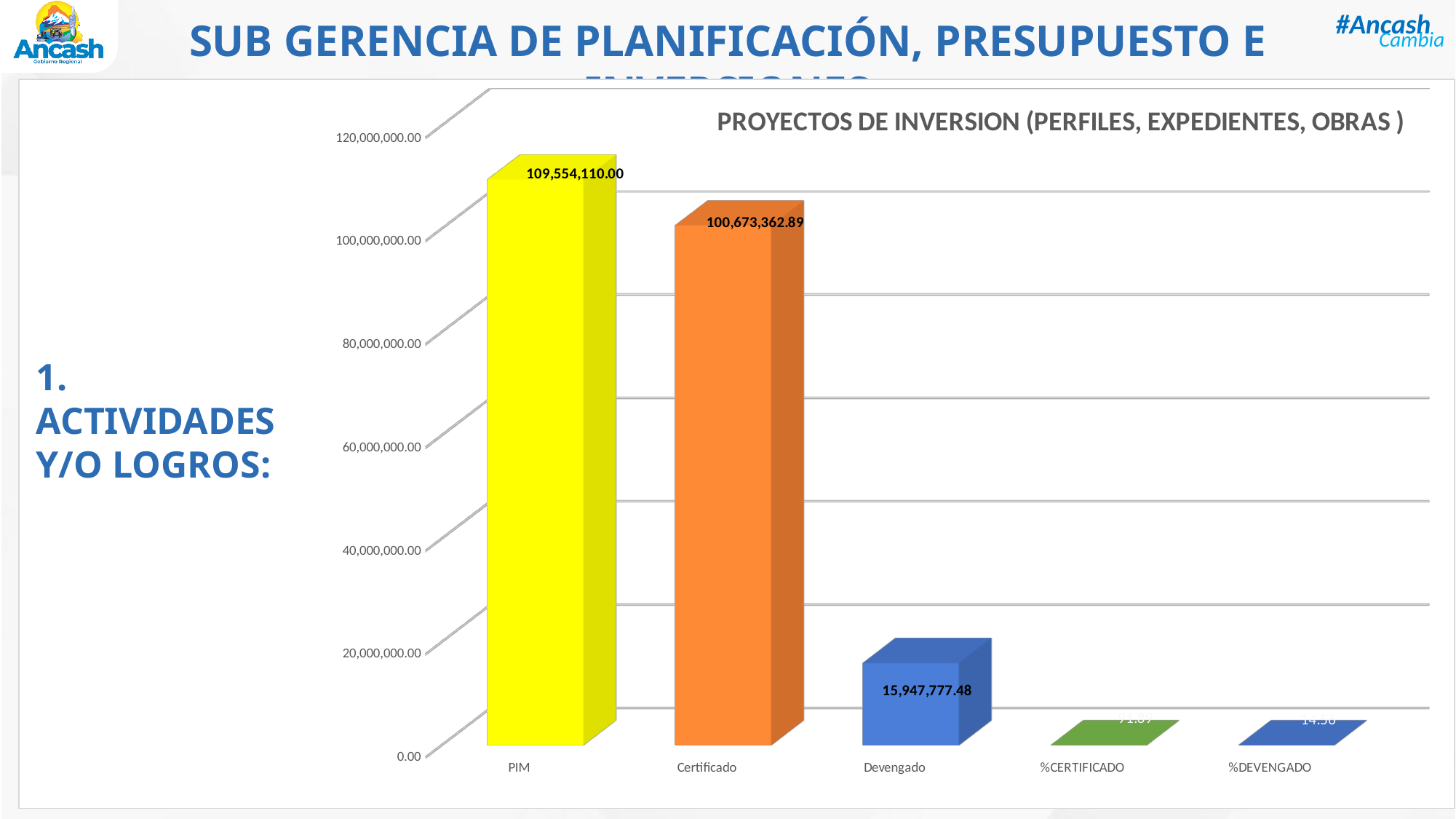
What is the value for Devengado? 15,947,777.48 What is the difference between the Certificado value and the Devengado value? 84,725,585.41 Which category has the highest value? PIM What kind of chart is shown on the slide? Bar chart Is the value for Devengado greater or less than 20,000,000.00? less What is the title of the chart? PROYECTOS DE INVERSION (PERFILES, EXPEDIENTES, OBRAS ) What is the value for PIM? 109,554,110.00 What is the value for Certificado? 100,673,362.89 How many categories are shown on the x axis? 5 Which of PIM, Certificado and Devengado has the lowest value? Devengado What is the difference between the PIM value and the Certificado value? 8,880,747.11 Which is larger, the value for Certificado or the value for Devengado? Certificado